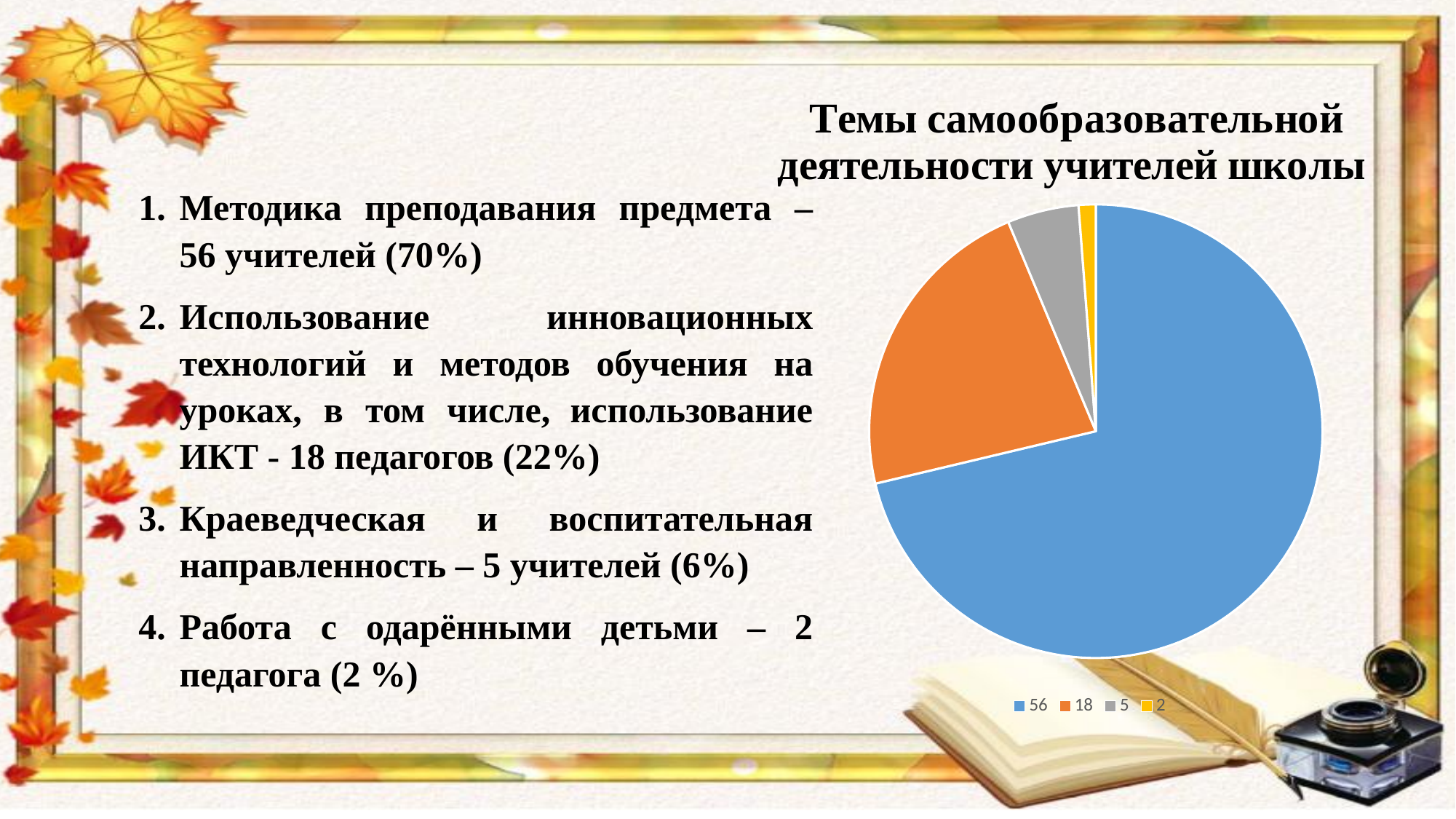
How many entries does the legend of the pie chart list? 4 What colour is the largest slice of the pie chart? blue Which legend entry corresponds to the largest slice of the pie chart? 56 What is the total of all the values shown in the pie chart legend (56, 18, 5, 2)? 81 What kind of chart is shown on the slide? pie chart Which is larger in the pie chart, the orange slice (18) or the grey slice (5)? orange slice (18) What is the difference between the values of the blue slice (56) and the orange slice (18) in the pie chart? 38 Which legend entry does the orange slice of the pie chart represent? 18 Which legend entry corresponds to the smallest slice of the pie chart? 2 How many slices does the pie chart have? 4 Which legend entry does the grey slice of the pie chart represent? 5 What are the legend entries of the pie chart, in order? 56, 18, 5, 2